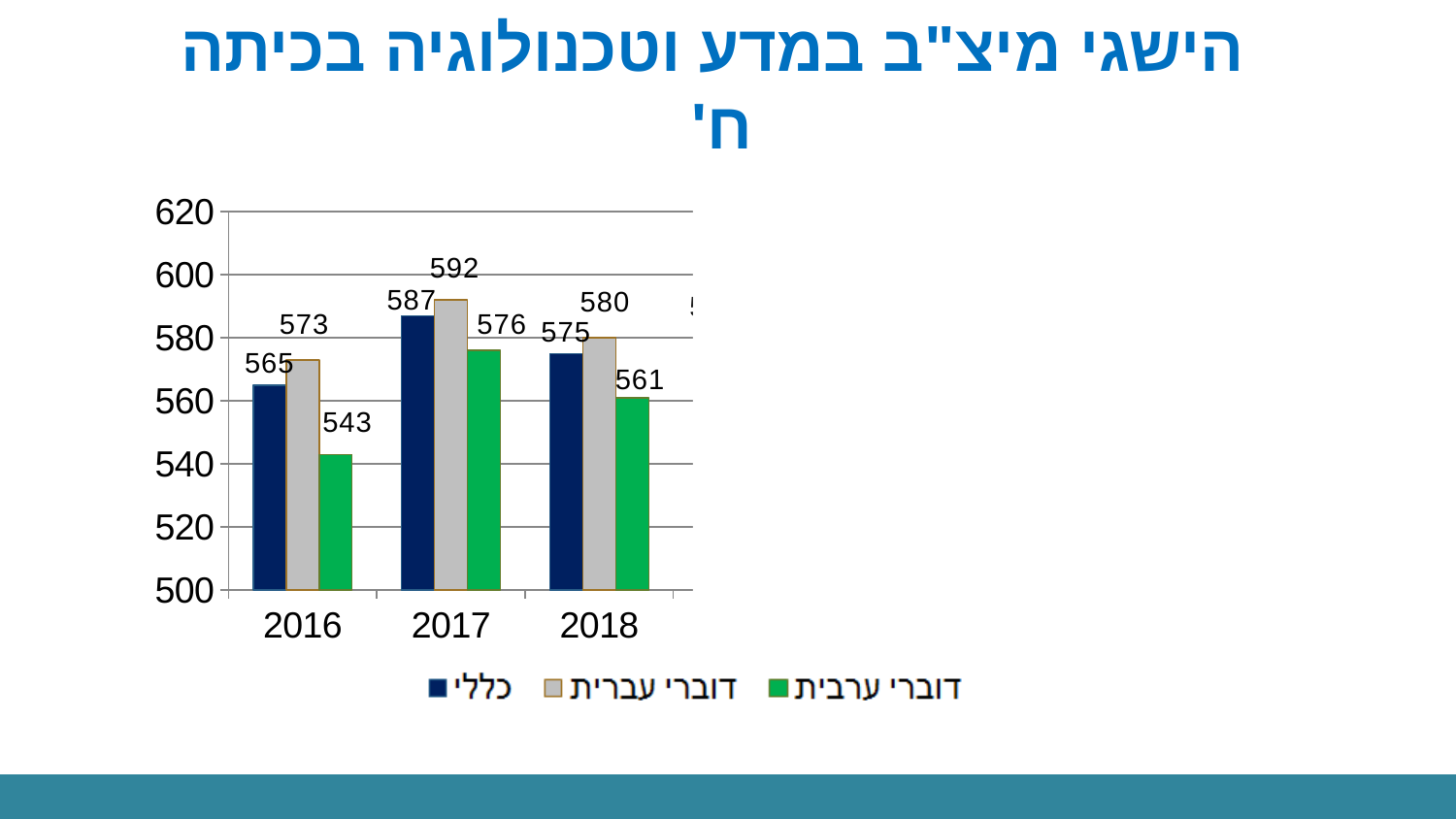
What is the value for כללי in 2017? 587 What kind of chart is shown on the slide? Bar chart What is the difference between the כללי values in 2017 and 2018? 12 What is the value for דוברי עברית in 2018? 580 What is the value for דוברי ערבית in 2016? 543 What is the value for דוברי עברית in 2017? 592 How many series does the legend list? 3 Which is larger in 2018: the value for כללי or the value for דוברי ערבית? כללי Which colour represents דוברי ערבית in the chart? Green What is the difference between the דוברי עברית and דוברי ערבית values in 2016? 30 In which year is the value for דוברי ערבית the lowest? 2016